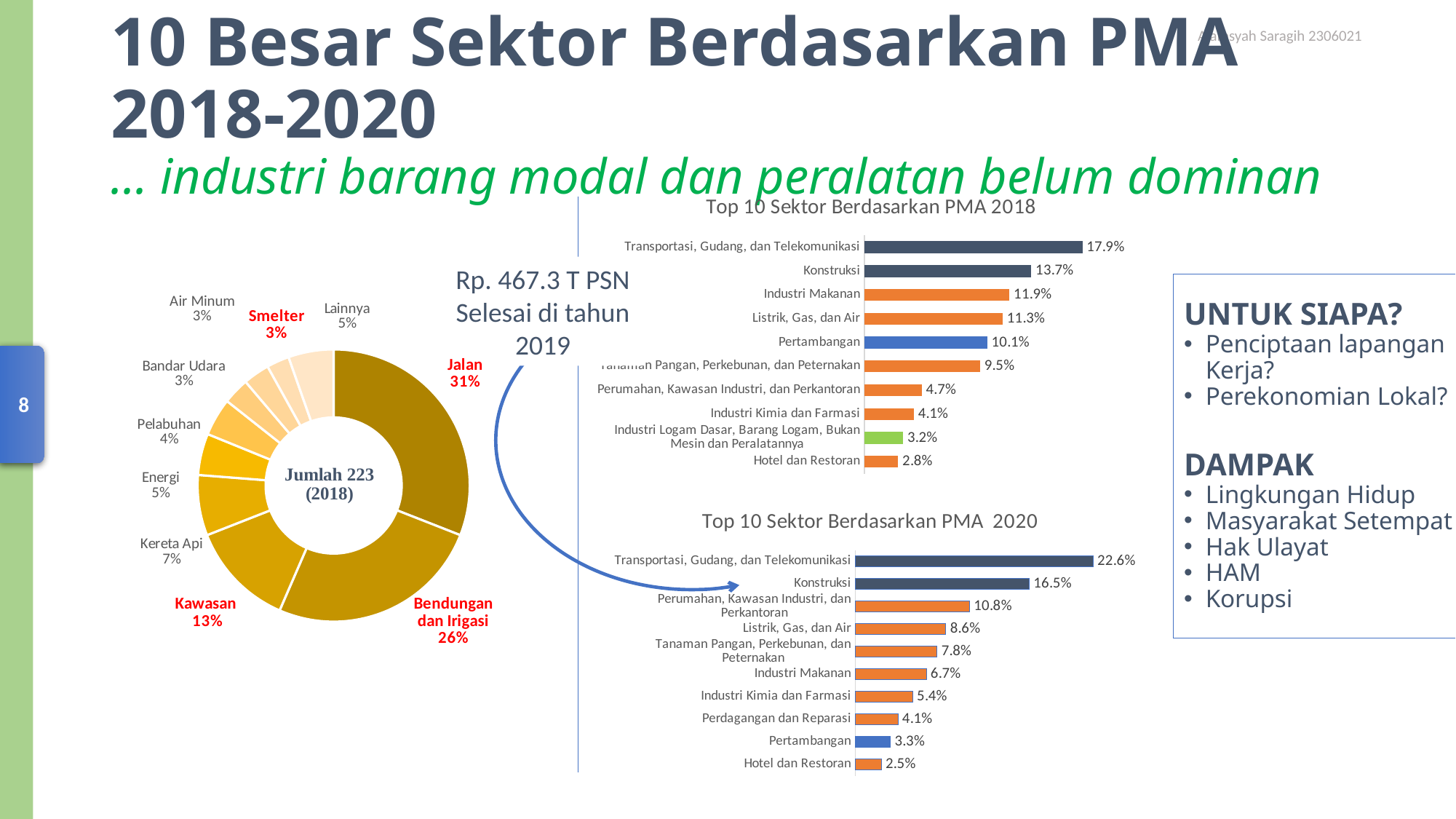
In the 'Top 10 Sektor Berdasarkan PMA 2018' chart, what is the value for Konstruksi? 13.7% In the 'Top 10 Sektor Berdasarkan PMA 2020' chart, what is the difference between Transportasi, Gudang, dan Telekomunikasi and Konstruksi? 6.1% In the 'Top 10 Sektor Berdasarkan PMA 2020' chart, how many sectors are shown? 10 What kind of chart is the 'Top 10 Sektor Berdasarkan PMA 2018' chart? Bar chart In the 'Top 10 Sektor Berdasarkan PMA 2018' chart, which sector has the lowest value? Hotel dan Restoran In the donut chart on the left, what share does Jalan have? 31% In the 'Top 10 Sektor Berdasarkan PMA 2018' chart, which sector has the highest value? Transportasi, Gudang, dan Telekomunikasi In the 'Top 10 Sektor Berdasarkan PMA 2020' chart, what is the value for Perumahan, Kawasan Industri, dan Perkantoran? 10.8% In the 'Top 10 Sektor Berdasarkan PMA 2020' chart, what is the value for Pertambangan? 3.3% In the donut chart on the left, which segment has the largest share? Jalan In the 'Top 10 Sektor Berdasarkan PMA 2018' chart, what is the difference between Industri Makanan and Listrik, Gas, dan Air? 0.6% Which is larger: Industri Makanan in the 2018 chart or Industri Makanan in the 2020 chart? 2018 (11.9%)